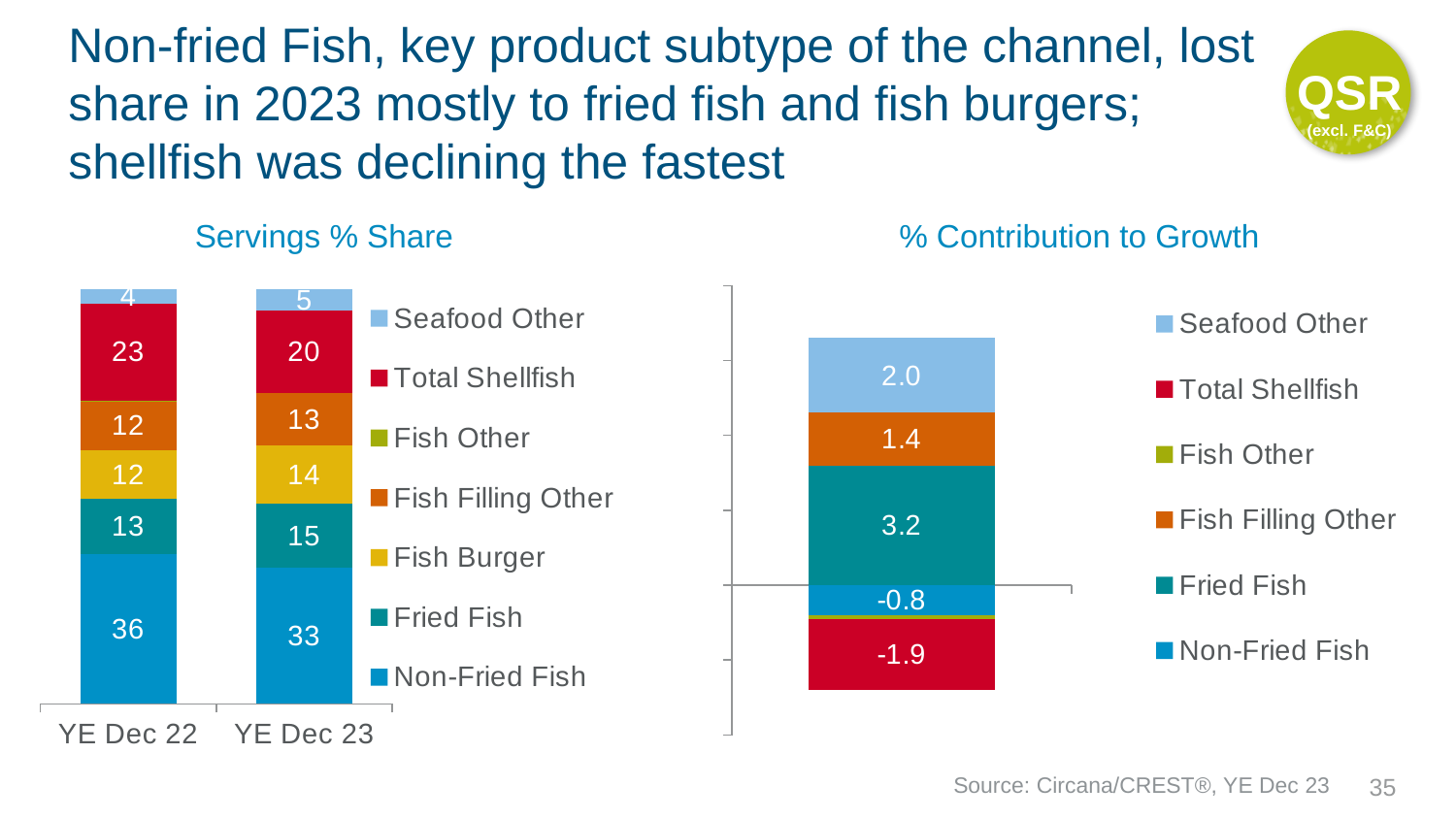
In the Servings % Share chart, by how much did the Non-Fried Fish share fall from YE Dec 22 to YE Dec 23? 3 How many series does the legend of the Servings % Share chart list? 7 In the Servings % Share chart, which segment is the largest in the YE Dec 23 bar? Non-Fried Fish In the % Contribution to Growth chart, what is the value for Total Shellfish? -1.9 In the Servings % Share chart, what is the value for Total Shellfish in YE Dec 22? 23 In the % Contribution to Growth chart, what is the value for Fried Fish? 3.2 In the % Contribution to Growth chart, which series has the lowest value? Total Shellfish In the Servings % Share chart, does the Total Shellfish share rise or fall from YE Dec 22 to YE Dec 23? fall In the Servings % Share chart, what is the value for Non-Fried Fish in YE Dec 23? 33 How many bars are shown in the Servings % Share chart? 2 In the Servings % Share chart, which is larger in YE Dec 23: Fried Fish or Fish Burger? Fried Fish What kind of chart is the Servings % Share chart? stacked bar chart